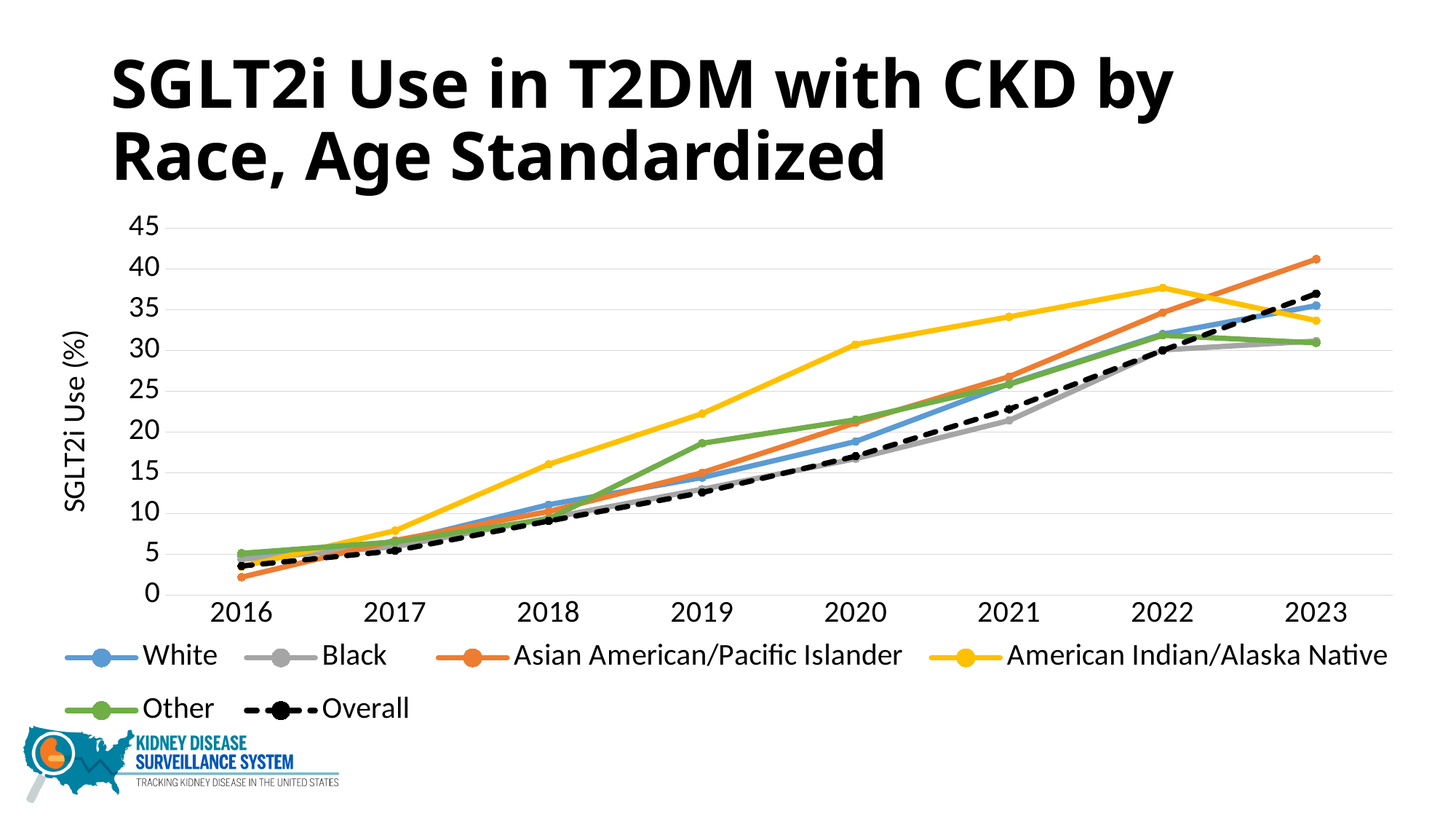
Is the value for American Indian/Alaska Native in 2023 greater or less than 35? less How many years are plotted along the x axis? 8 What kind of chart is shown on the slide? line chart Is the value for Black in 2021 greater or less than 25? less What is the label on the y axis? SGLT2i Use (%) Which series has the highest SGLT2i use in 2023? Asian American/Pacific Islander Which series has the highest SGLT2i use in 2020? American Indian/Alaska Native Is the value for Asian American/Pacific Islander in 2023 greater or less than 40? greater How many series does the legend list? 6 Which series has the lowest SGLT2i use in 2016? Asian American/Pacific Islander In 2019, which is larger: the value for American Indian/Alaska Native or the value for White? American Indian/Alaska Native Does the Asian American/Pacific Islander line rise or fall from 2016 to 2023? rise